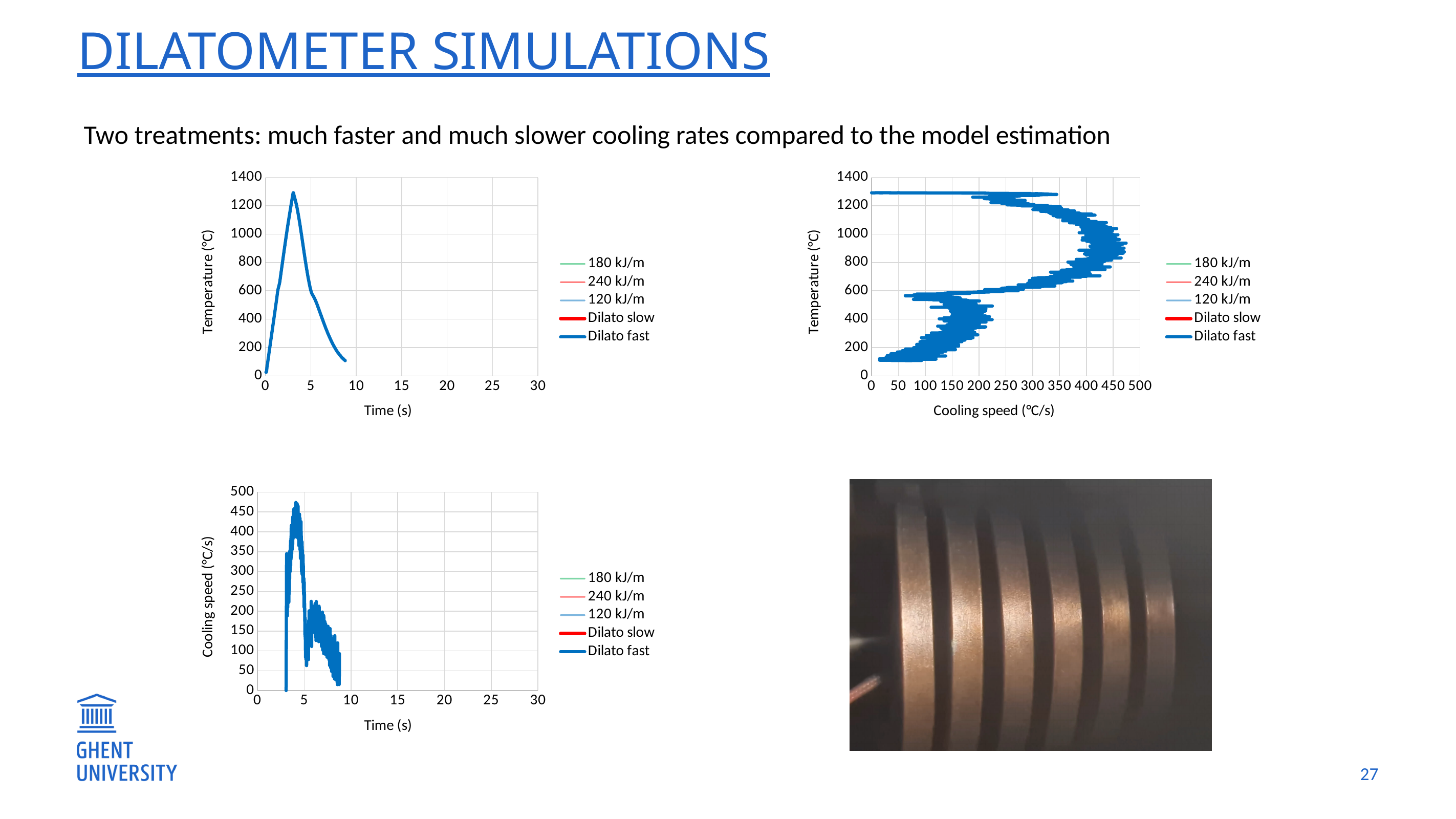
How many series does the legend of the top-left chart (Temperature vs Time) list? 5 In the top-left chart (Temperature vs Time), is the temperature of the Dilato fast curve at 5 s greater or less than 800? less In the top-left chart (Temperature vs Time), is the peak temperature of the Dilato fast curve greater or less than 1200? greater How many series does the legend of the top-right chart (Temperature vs Cooling speed) list? 5 In the bottom-left chart (Cooling speed vs Time), is the peak cooling speed of the Dilato fast curve greater or less than 400? greater In the legend of the bottom-left chart (Cooling speed vs Time), which series is shown in red? Dilato slow What kind of chart is the top-left chart (Temperature vs Time)? line chart What is the x-axis title of the top-right chart? Cooling speed (°C/s) What kind of chart is the top-right chart (Temperature vs Cooling speed)? line chart In the top-left chart (Temperature vs Time), does the Dilato fast temperature rise or fall between 5 s and 9 s? fall